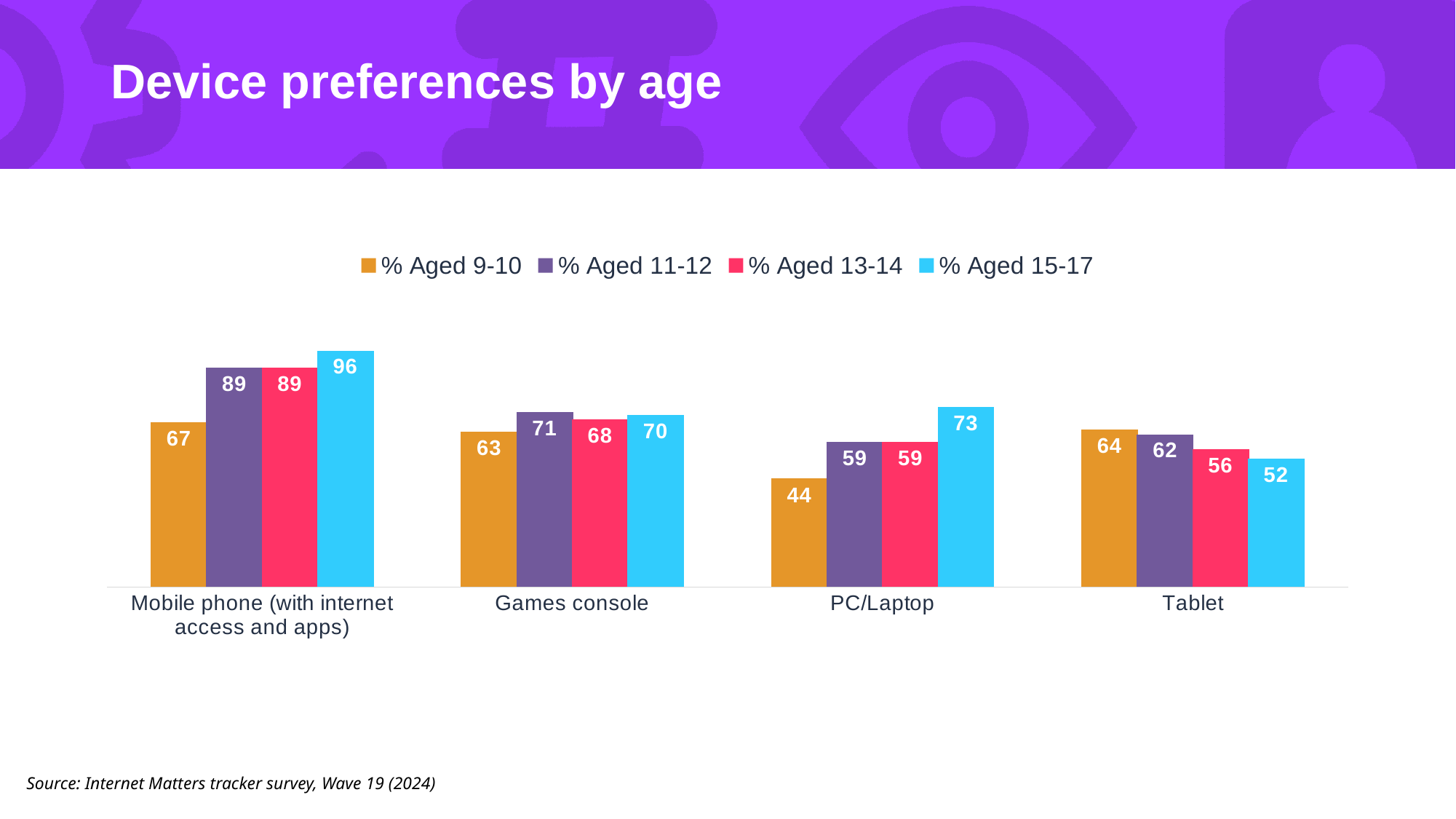
What is the value for % Aged 15-17 for Mobile phone (with internet access and apps)? 96 What is the title of the slide? Device preferences by age Which is larger for Games console: % Aged 11-12 or % Aged 13-14? % Aged 11-12 What is the value for % Aged 13-14 for Tablet? 56 What is the difference between the % Aged 15-17 and % Aged 9-10 values for PC/Laptop? 29 What kind of chart is shown on the slide? Bar chart Which device has the highest value for % Aged 11-12? Mobile phone (with internet access and apps) What is the value for % Aged 9-10 for PC/Laptop? 44 Which device has the lowest value for % Aged 15-17? Tablet Do the values for Tablet rise or fall from % Aged 9-10 to % Aged 15-17? Fall How many series does the legend list? 4 How many device categories are shown on the x axis? 4